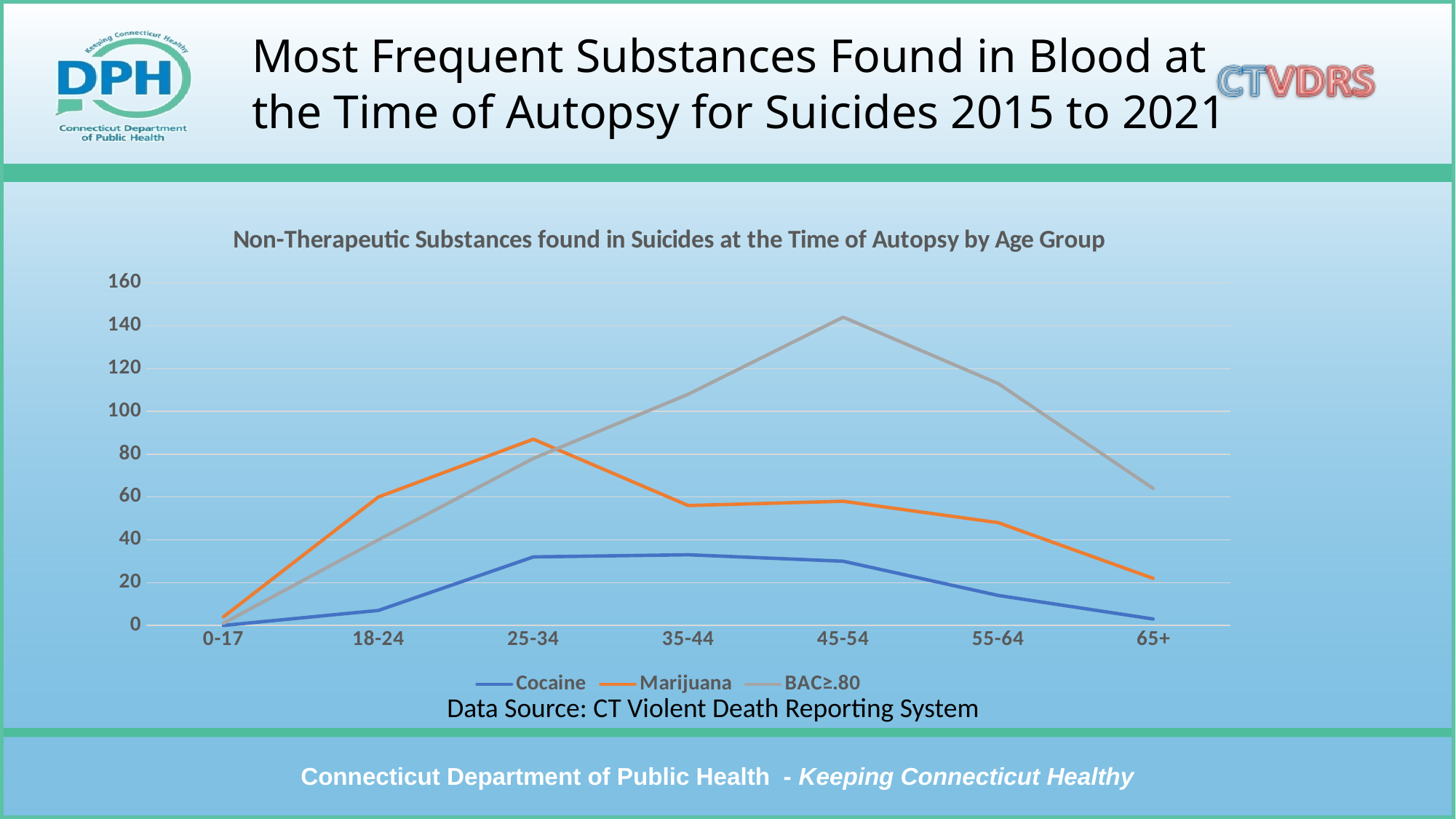
How many age groups are shown on the x axis of the chart? 7 Which age group has the highest value for BAC≥.80? 45-54 What kind of chart is shown on the slide? line chart Which age group has the highest value for Marijuana? 25-34 Is the value for Marijuana in the 18-24 age group greater or less than 40? greater What is the title of the chart? Non-Therapeutic Substances found in Suicides at the Time of Autopsy by Age Group Is the value for BAC≥.80 in the 35-44 age group greater or less than 100? greater In the 45-54 age group, which is larger: BAC≥.80 or Marijuana? BAC≥.80 Which age group has the lowest value for Cocaine? 0-17 Does the BAC≥.80 line rise or fall from the 0-17 age group to the 45-54 age group? rise How many series does the chart's legend list? 3 Is the value for Cocaine in the 25-34 age group greater or less than 40? less